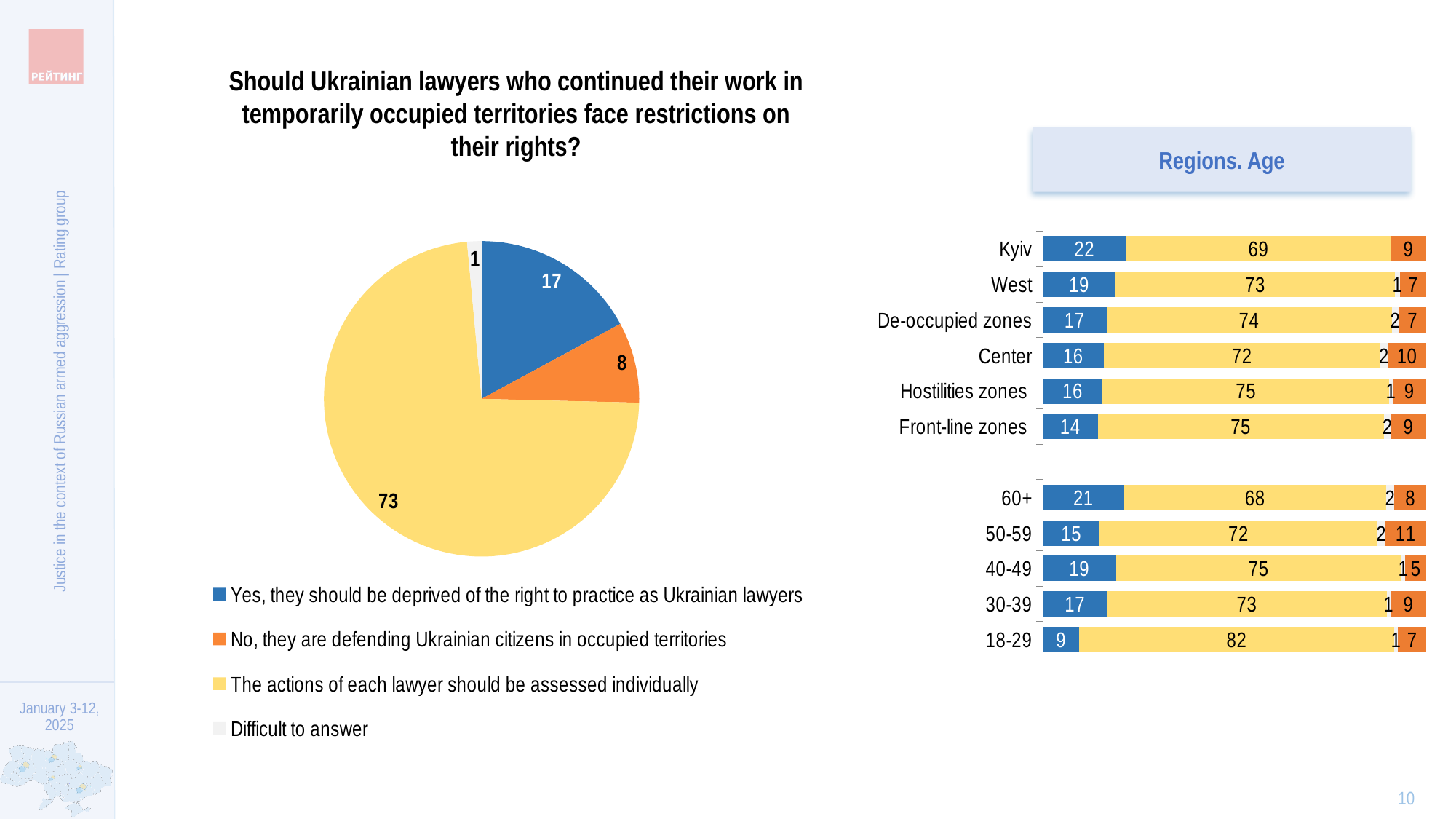
In the 'Regions. Age' chart, which category has the highest value in the yellow segment? 18-29 How many entries does the legend below the pie chart list? 4 In the 'Regions. Age' chart, what is the value of the yellow segment for the 18-29 age group? 82 In the 'Regions. Age' chart, what is the value of the blue segment for Kyiv? 22 In the 'Regions. Age' chart, which category has the lowest value in the blue segment? 18-29 In the pie chart, what value is shown for 'Yes, they should be deprived of the right to practice as Ukrainian lawyers'? 17 In the 'Regions. Age' chart, is the blue segment larger for Kyiv or for Front-line zones? Kyiv What kind of chart is the 'Regions. Age' chart? Stacked bar chart In the pie chart, which response has the smallest slice? Difficult to answer How many categories (regions and age groups combined) are shown in the 'Regions. Age' chart? 11 In the pie chart, what share of respondents said the actions of each lawyer should be assessed individually? 73 In the pie chart, what is the difference between the 'Yes, they should be deprived' slice and the 'No, they are defending Ukrainian citizens' slice? 9